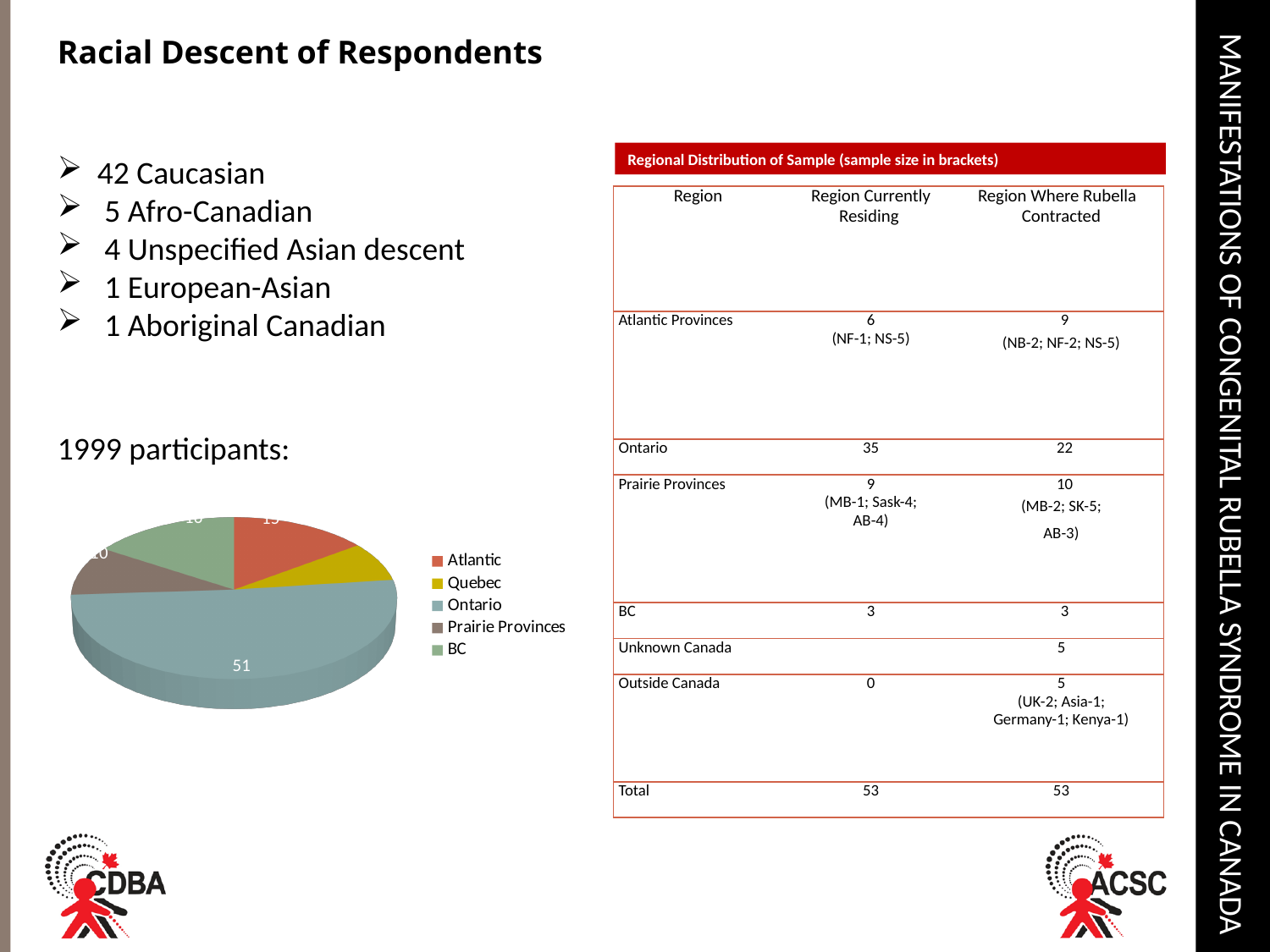
Which region has the smallest slice in the pie chart? Quebec Which region has the largest slice in the pie chart? Ontario In the pie chart, which is larger: BC or Quebec? BC What kind of chart is shown on the slide? pie chart How many regions does the pie chart's legend list? 5 Which region is shown in yellow in the pie chart? Quebec How many slices does the pie chart have? 5 Which legend entry is listed first in the pie chart's legend? Atlantic What is the value shown for Ontario in the pie chart? 51 In the pie chart, which is larger: Ontario or Atlantic? Ontario In the pie chart, which is larger: Atlantic or Quebec? Atlantic